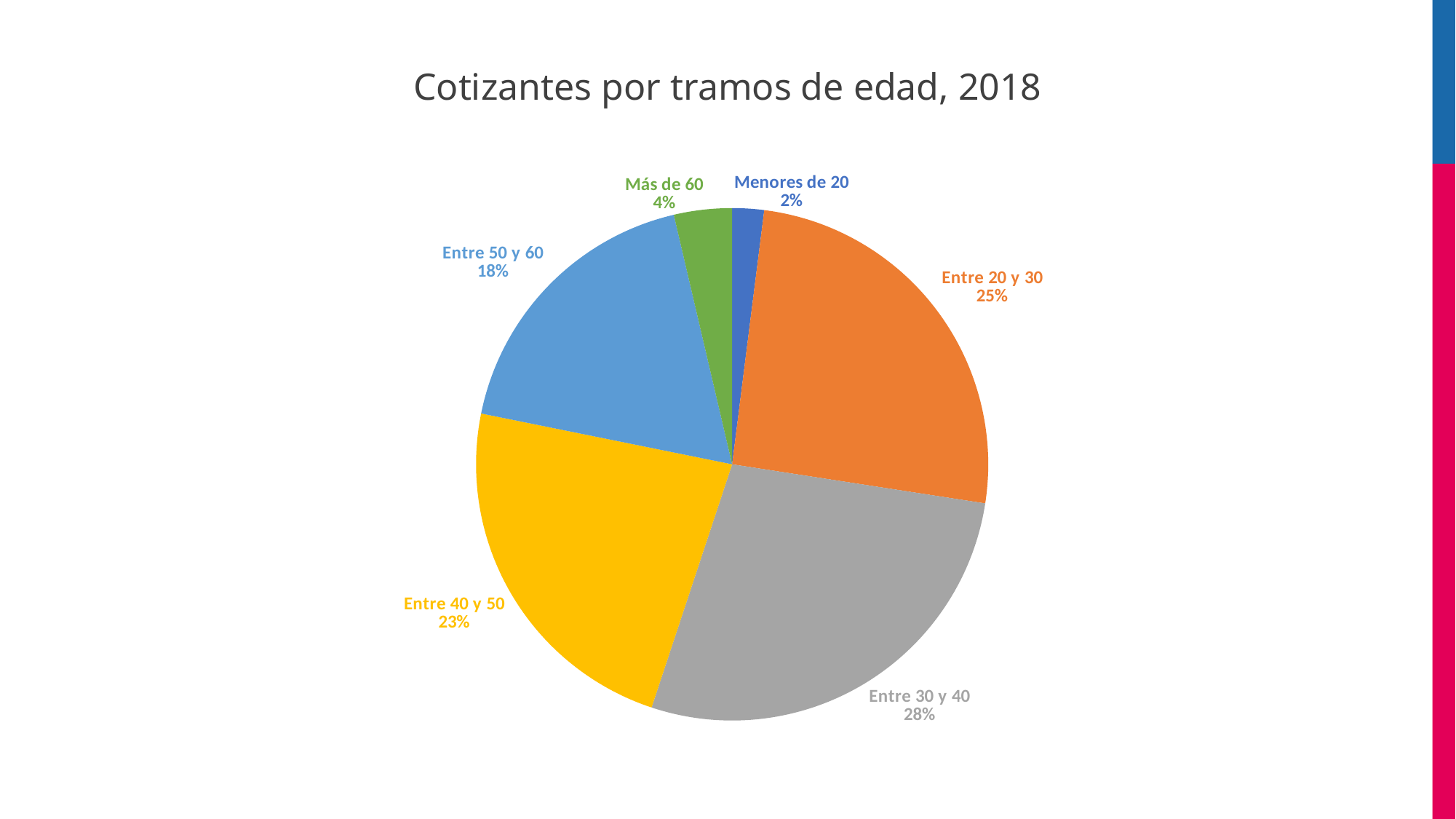
What percentage of the pie is the 'Entre 30 y 40' slice? 28% What percentage is shown for 'Entre 40 y 50'? 23% What percentage is shown for 'Entre 50 y 60'? 18% Which is larger, the share for 'Más de 60' or the share for 'Menores de 20'? Más de 60 What is the difference in percentage points between 'Entre 30 y 40' and 'Entre 50 y 60'? 10 What type of chart is shown on the slide? Pie chart What percentage is shown for 'Entre 20 y 30'? 25% How many age groups are shown in the pie chart? 6 What is the title of the chart? Cotizantes por tramos de edad, 2018 Which age group has the largest share of the pie? Entre 30 y 40 Which age group has the smallest share of the pie? Menores de 20 What percentage is shown for 'Menores de 20'? 2%